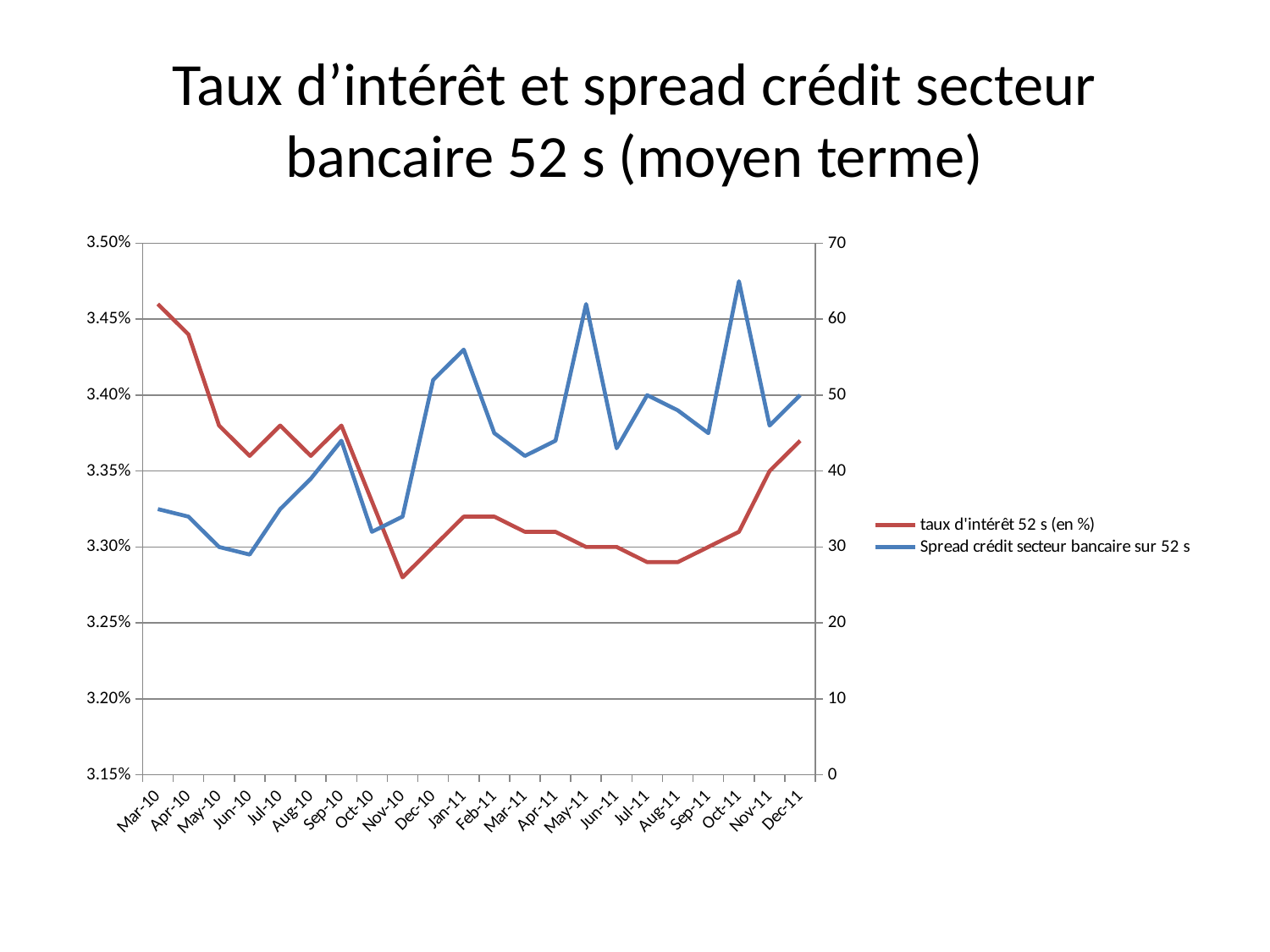
How many months are plotted along the x axis? 22 In which month is the 'taux d'intérêt 52 s (en %)' series at its highest? Mar-10 Is the value of 'taux d'intérêt 52 s (en %)' in Nov-10 greater or less than 3.30%? less Which is larger for 'Spread crédit secteur bancaire sur 52 s': the value in Oct-11 or the value in Jan-11? Oct-11 Does the 'taux d'intérêt 52 s (en %)' series rise or fall between Mar-10 and Nov-10? fall Is the value of 'Spread crédit secteur bancaire sur 52 s' in Jun-10 greater or less than 40? less What kind of chart is shown on the slide? line chart Is the value of 'Spread crédit secteur bancaire sur 52 s' in Oct-11 greater or less than 60? greater In which month does the 'Spread crédit secteur bancaire sur 52 s' series reach its highest value? Oct-11 In which month is the 'taux d'intérêt 52 s (en %)' series at its lowest? Nov-10 How many series does the legend list? 2